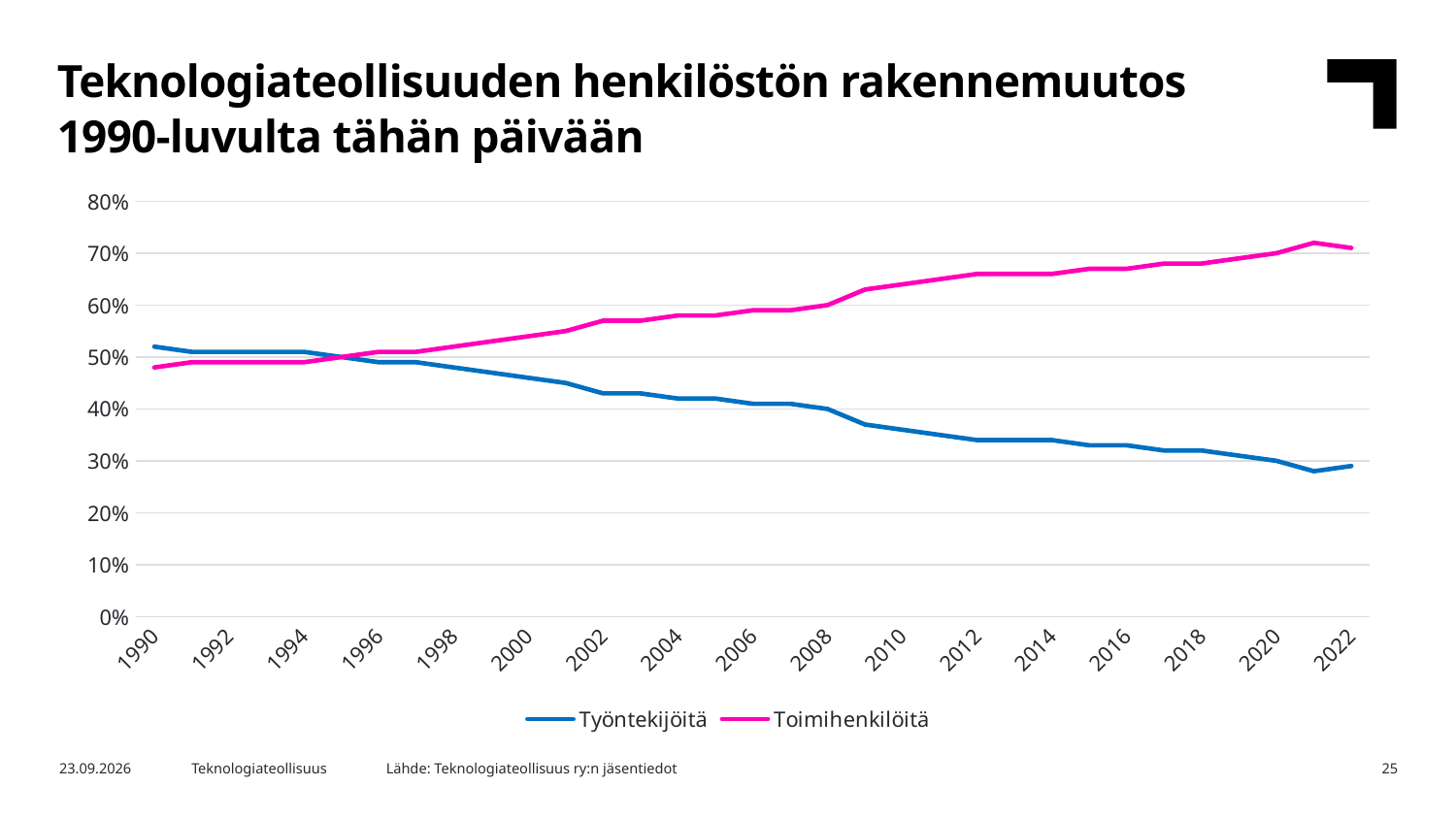
Is the value for Työntekijöitä in 1990 greater or less than 50%? greater In 2022, which series has the higher value, Työntekijöitä or Toimihenkilöitä? Toimihenkilöitä Does the Työntekijöitä line rise or fall from 1990 to 2022? Fall Is the value for Toimihenkilöitä in 2010 greater or less than 60%? greater What kind of chart is shown on the slide? Line chart Is the value for Toimihenkilöitä in 1990 greater or less than 50%? less What is the title of the chart on the slide? Teknologiateollisuuden henkilöstön rakennemuutos 1990-luvulta tähän päivään What are the two series named in the legend? Työntekijöitä and Toimihenkilöitä How many series does the legend list? 2 In 1990, which series has the higher value, Työntekijöitä or Toimihenkilöitä? Työntekijöitä Does the Toimihenkilöitä line rise or fall from 1990 to 2022? Rise